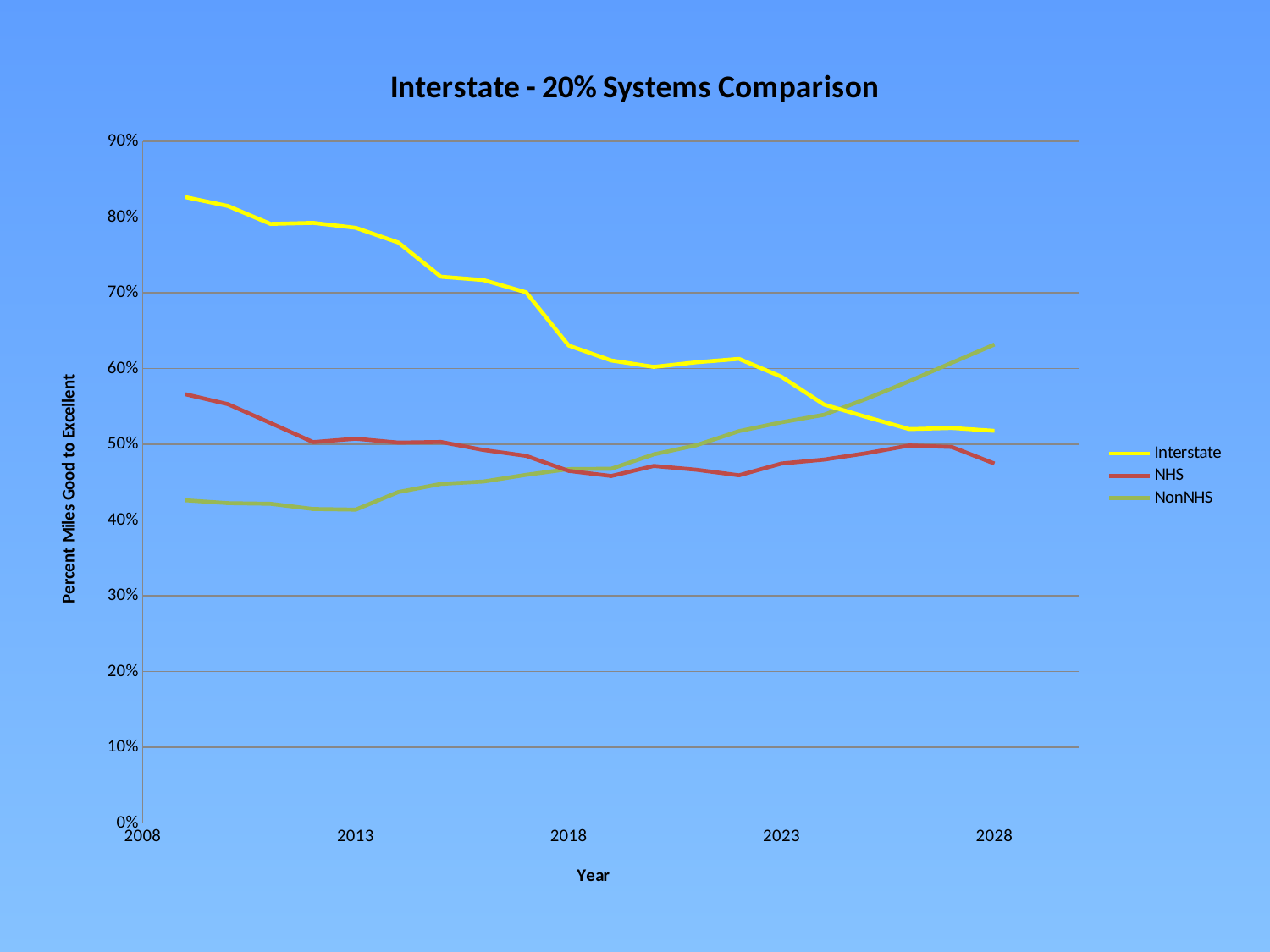
Is the value for NHS in 2018 greater or less than 50%? less Is the value for Interstate in 2013 greater or less than 70%? greater Which series has the highest value in 2013? Interstate What is the title of the chart? Interstate - 20% Systems Comparison Is the value for Interstate in 2028 greater or less than 60%? less What kind of chart is shown on the slide? line chart Does the Interstate series rise or fall from 2008 to 2028? fall What is the label on the vertical axis? Percent Miles Good to Excellent Does the NonNHS series rise or fall from 2013 to 2028? rise In 2028, which is larger, NonNHS or NHS? NonNHS How many series does the legend list? 3